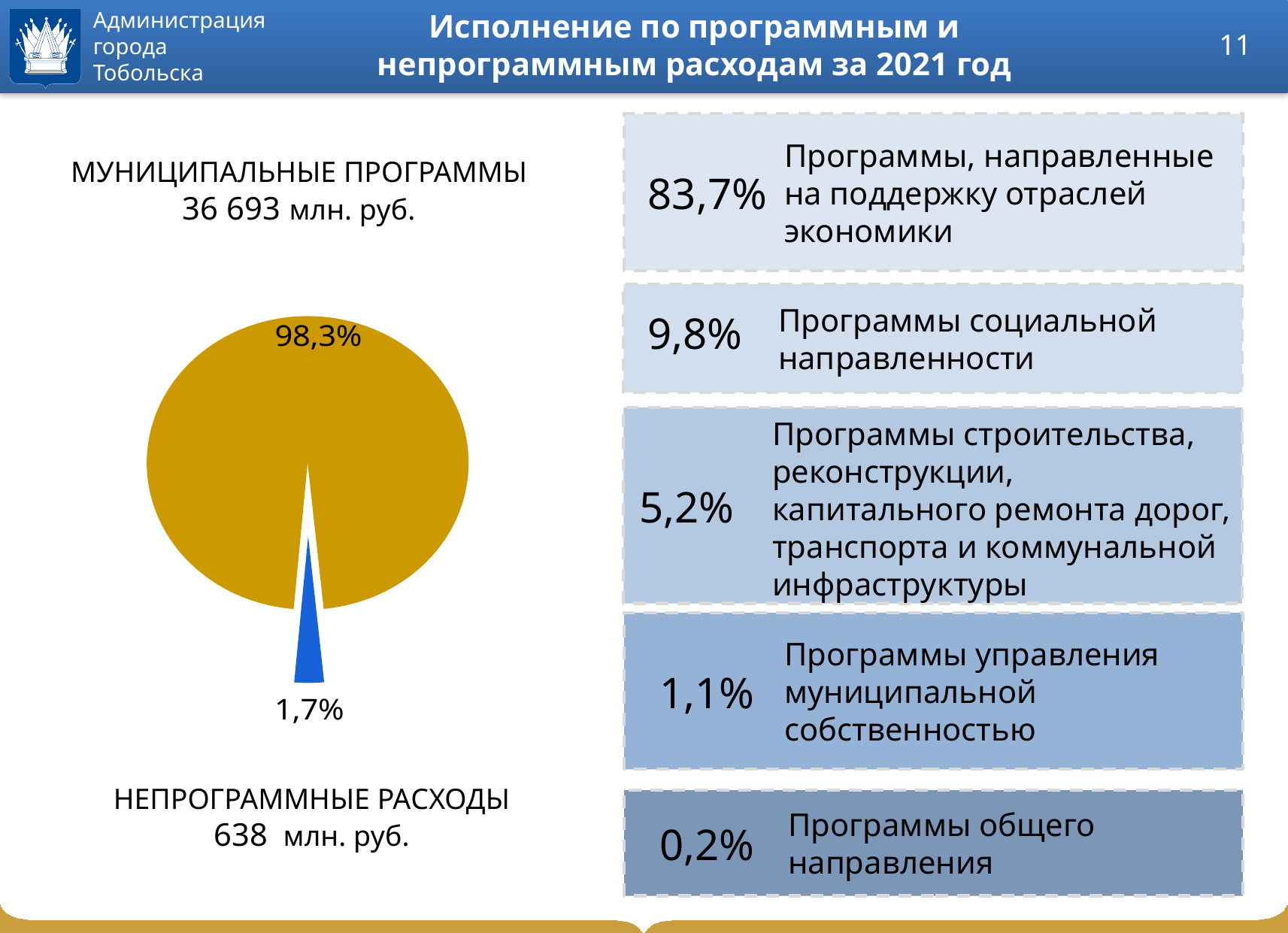
What amount in млн. руб. is shown for МУНИЦИПАЛЬНЫЕ ПРОГРАММЫ next to the pie chart? 36 693 млн. руб. What share of the pie chart is labelled 98,3%? МУНИЦИПАЛЬНЫЕ ПРОГРАММЫ What percentage does the pie chart show for МУНИЦИПАЛЬНЫЕ ПРОГРАММЫ? 98,3% How many slices does the pie chart have? 2 What is the difference in percentage points between the two slices of the pie chart? 96,6 What kind of chart is shown on the slide? pie chart Which is larger in the pie chart: МУНИЦИПАЛЬНЫЕ ПРОГРАММЫ or НЕПРОГРАММНЫЕ РАСХОДЫ? МУНИЦИПАЛЬНЫЕ ПРОГРАММЫ What amount in млн. руб. is shown for НЕПРОГРАММНЫЕ РАСХОДЫ next to the pie chart? 638 млн. руб. Which slice of the pie chart is the smallest? НЕПРОГРАММНЫЕ РАСХОДЫ Which slice of the pie chart is the largest? МУНИЦИПАЛЬНЫЕ ПРОГРАММЫ What percentage does the pie chart show for НЕПРОГРАММНЫЕ РАСХОДЫ? 1,7% What colour is the slice for НЕПРОГРАММНЫЕ РАСХОДЫ in the pie chart? blue